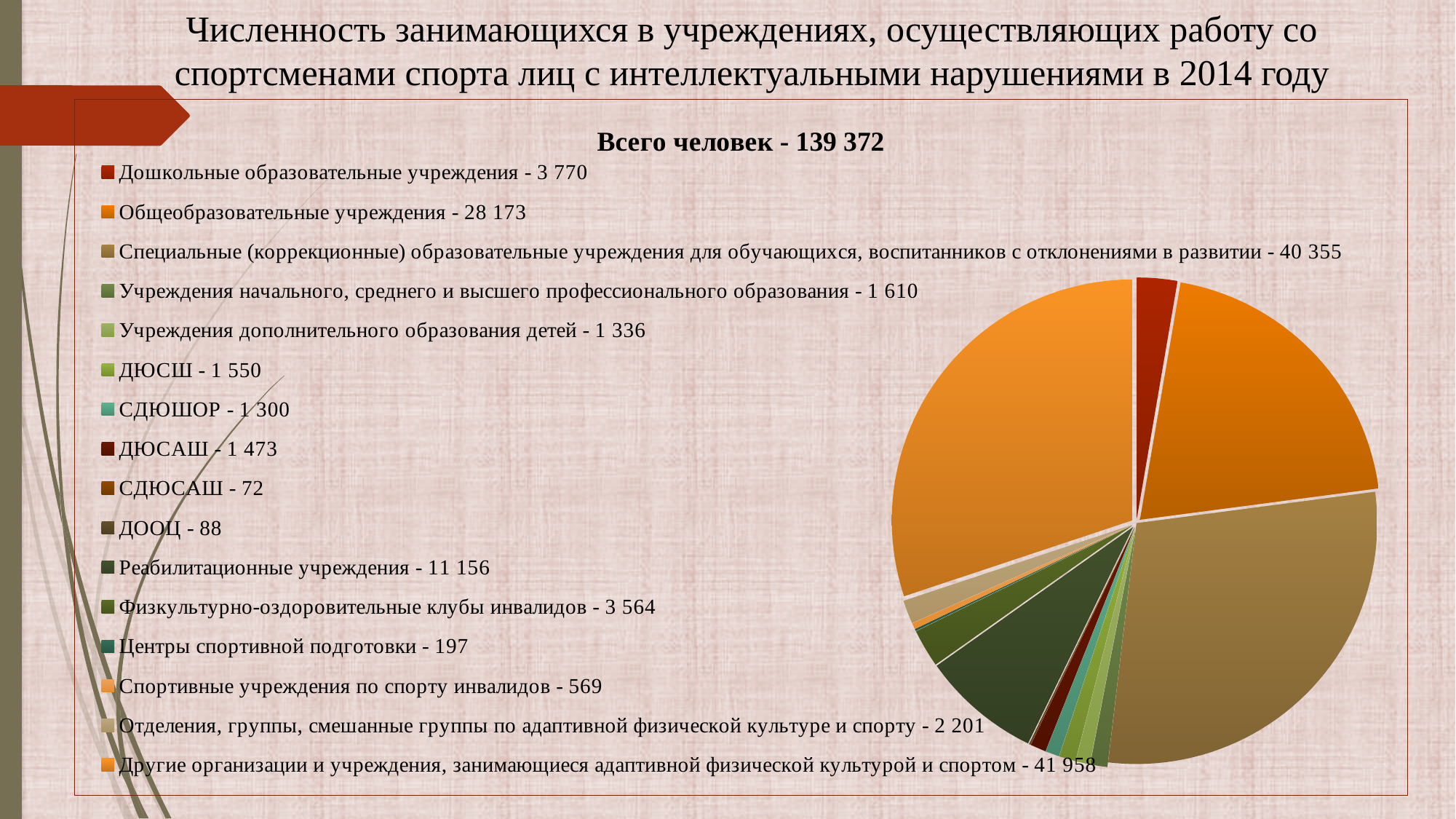
What share of the total (139 372) does Другие организации и учреждения (41 958) represent, to one decimal place? 30.1% What is the difference between the values for Другие организации и учреждения and Специальные (коррекционные) образовательные учреждения? 1 603 Which category has the lowest value? СДЮСАШ What total number of people is stated above the chart? 139 372 What is the value for Реабилитационные учреждения? 11 156 What is the value for Общеобразовательные учреждения? 28 173 Which is larger, the value for ДЮСШ or the value for СДЮШОР? ДЮСШ How many categories does the pie chart's legend list? 16 Which category has the highest value? Другие организации и учреждения, занимающиеся адаптивной физической культурой и спортом What is the value for Центры спортивной подготовки? 197 What is the difference between the values for Общеобразовательные учреждения and Реабилитационные учреждения? 17 017 What kind of chart is shown on the slide? pie chart